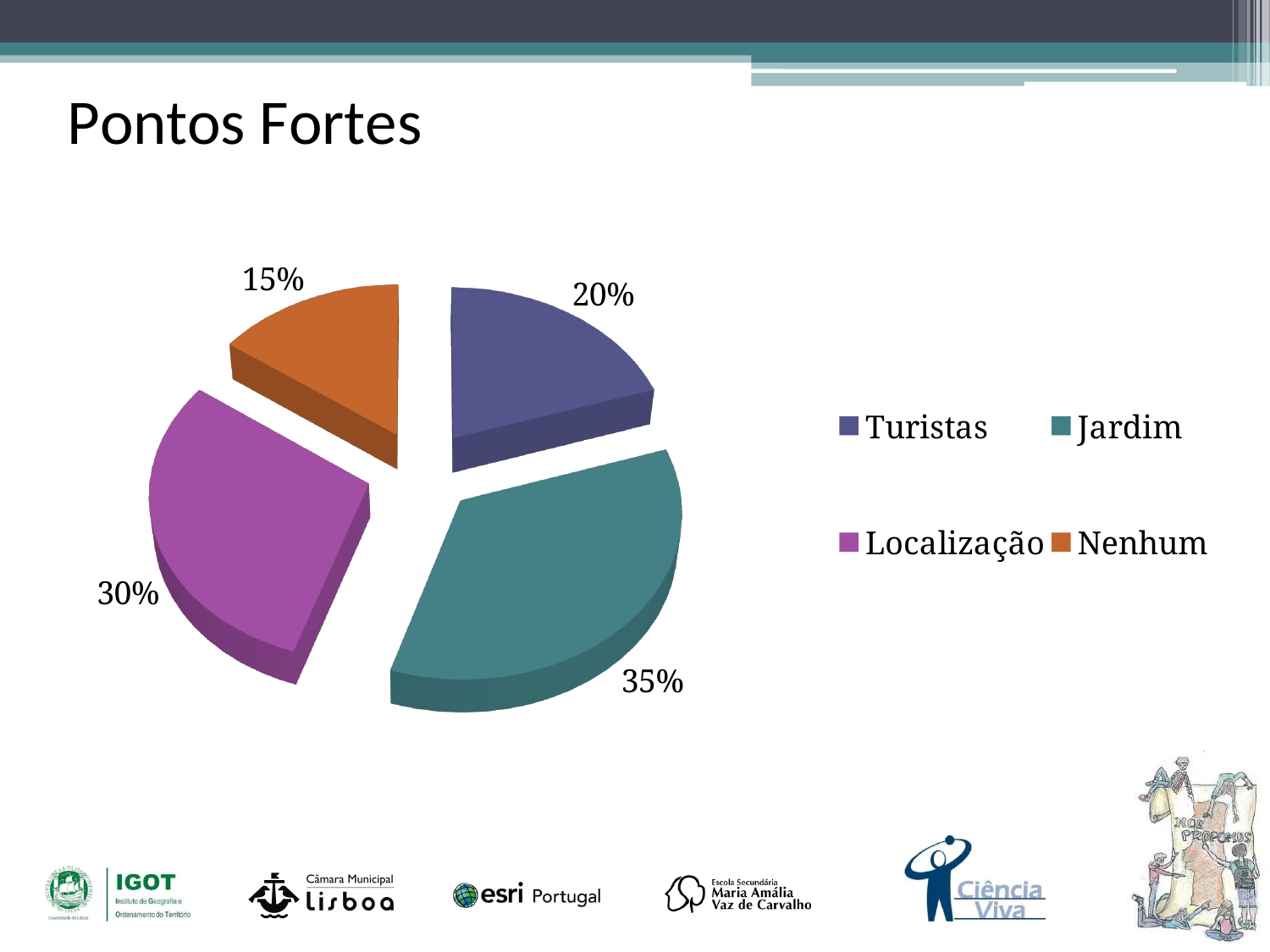
What percentage does the Localização slice represent? 30% Which category has the largest share of the pie? Jardim What colour is the Nenhum slice in the pie chart? orange What is the difference in percentage points between Jardim and Nenhum? 20 Which is larger, the Localização slice or the Turistas slice? Localização Which category has the smallest share of the pie? Nenhum How many slices does the pie chart have? 4 What percentage does the Nenhum slice represent? 15% What percentage does the Turistas slice represent? 20% What percentage does the Jardim slice represent? 35% What is the title of the slide containing the chart? Pontos Fortes What kind of chart is shown on the slide? pie chart